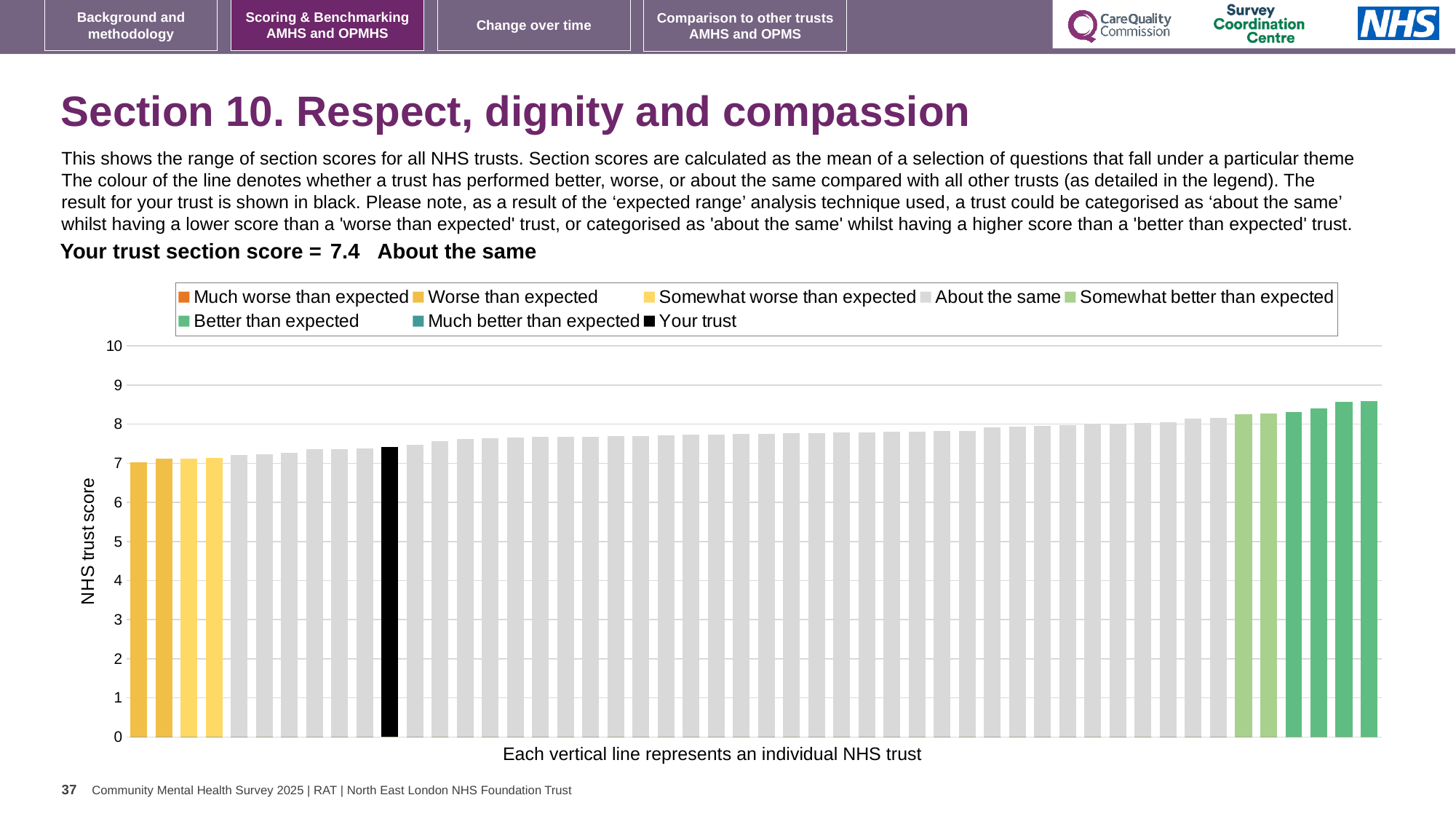
What is the label on the vertical axis of the chart? NHS trust score Which category is your trust placed in for this section? About the same Is the value of the black 'Your trust' bar greater or less than 7? greater How many bars are coloured as 'Better than expected' (dark green)? 4 How many entries does the chart legend list? 8 Is the value of the tallest bar (rightmost) greater or less than 9? less What colour is the bar representing your trust? black Do the bar values rise or fall from left to right along the x axis? rise What is the section score for your trust shown on the slide? 7.4 Is the value of the shortest bar (leftmost) greater or less than 6? greater What kind of chart is shown on the slide? bar chart